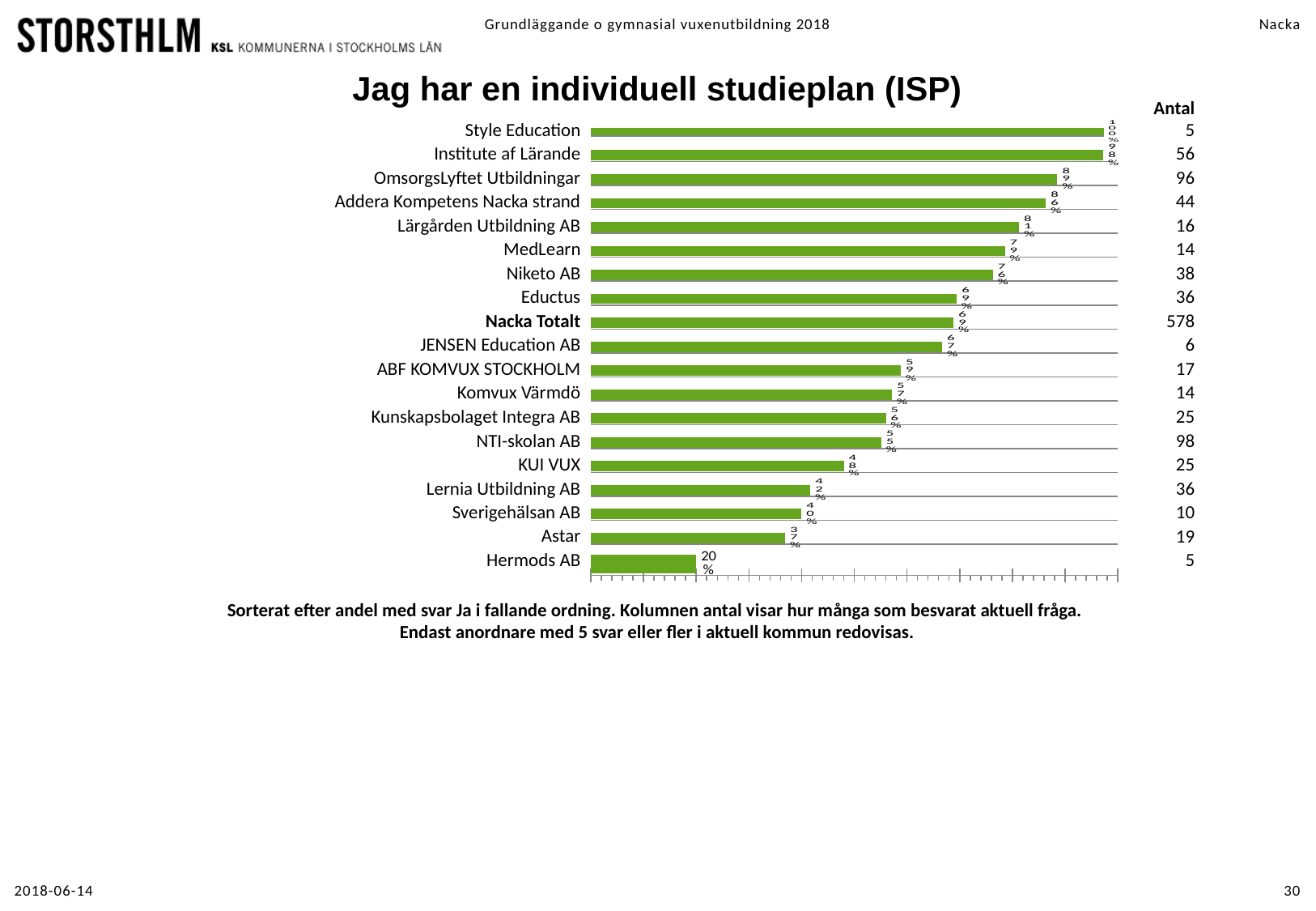
How many categories are plotted in the chart? 19 What is the value for Hermods AB? 20% What is the value for Nacka Totalt? 69% Do the values rise or fall going down the list of categories from top to bottom? fall What is the title of the chart? Jag har en individuell studieplan (ISP) What is the Antal value shown for Nacka Totalt? 578 What is the value for MedLearn? 79% Which category has the highest value? Style Education What is the difference between the values for Style Education and Hermods AB? 80% Which has a larger value, Niketo AB or KUI VUX? Niketo AB Which category has the lowest value? Hermods AB What type of chart is shown on the slide? bar chart